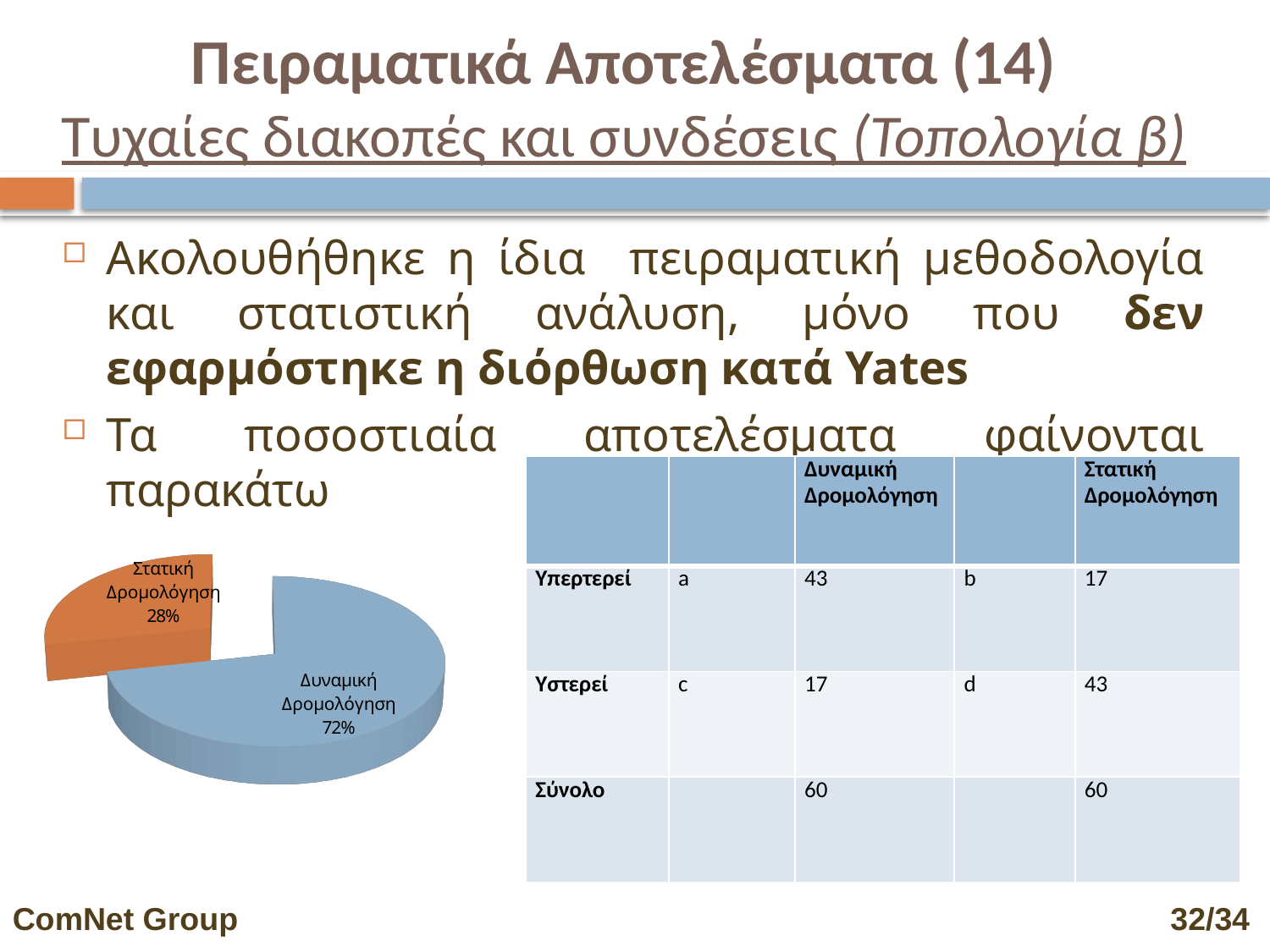
What percentage does the pie chart show for Δυναμική Δρομολόγηση? 72% How many slices does the pie chart have? 2 Which slice of the pie chart is the smallest? Στατική Δρομολόγηση What percentage does the pie chart show for Στατική Δρομολόγηση? 28% What colour is the Δυναμική Δρομολόγηση slice in the pie chart? blue Which slice of the pie chart is the largest? Δυναμική Δρομολόγηση What colour is the Στατική Δρομολόγηση slice in the pie chart? orange Which is larger in the pie chart, Στατική Δρομολόγηση or Δυναμική Δρομολόγηση? Δυναμική Δρομολόγηση What is the difference in percentage points between the Δυναμική Δρομολόγηση and Στατική Δρομολόγηση slices? 44 What share of the pie does the Στατική Δρομολόγηση slice represent? 28% What kind of chart is shown on the slide? pie chart